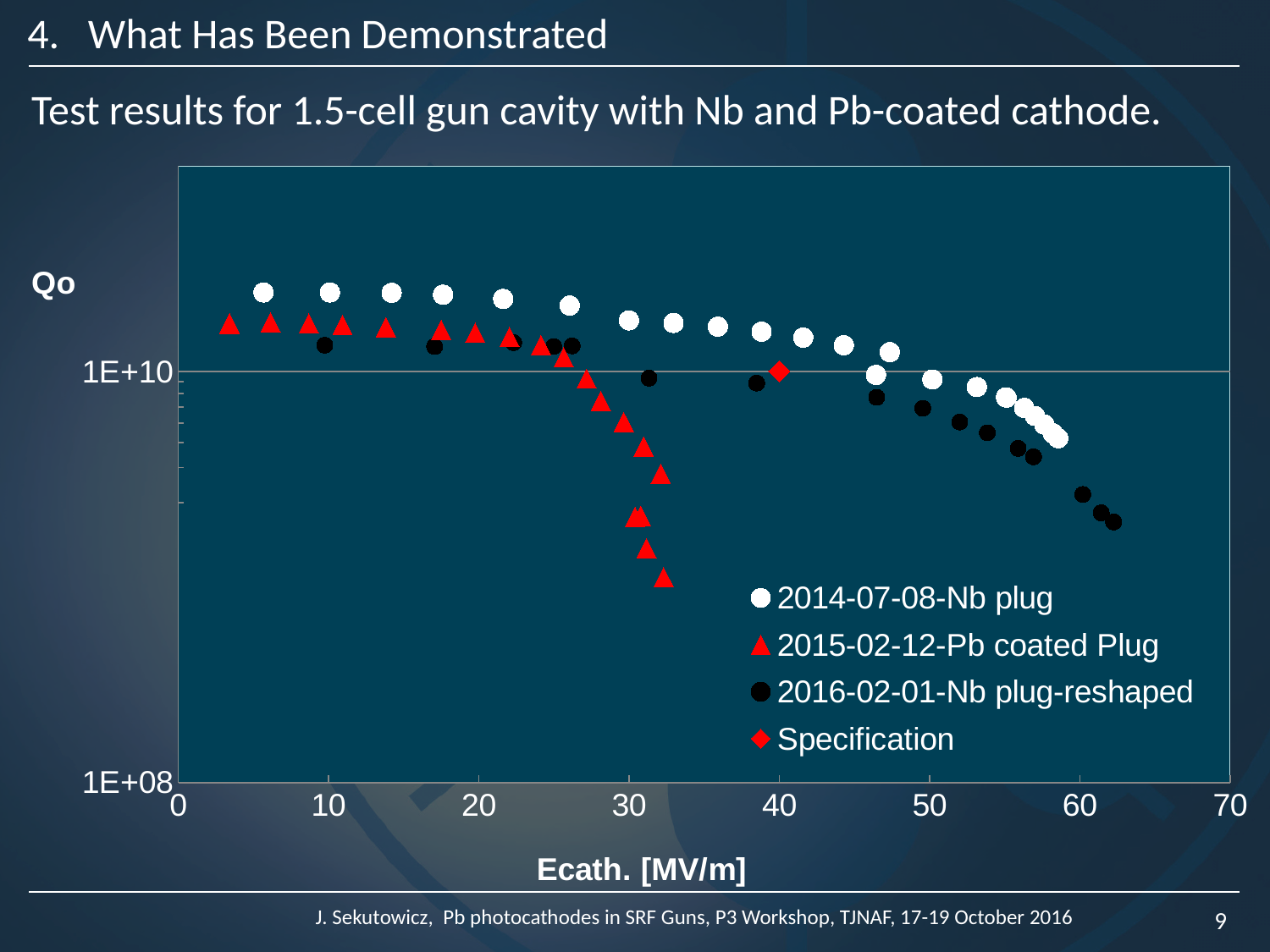
Is the Qo value for the 2015-02-12-Pb coated Plug series at its highest Ecath (around 32 MV/m) greater or less than 1E+10? less What is the label of the x axis of the chart? Ecath. [MV/m] Which series drops below 1E+10 at the lowest Ecath value? 2015-02-12-Pb coated Plug Which series reaches the highest Ecath value on the chart? 2016-02-01-Nb plug-reshaped At Ecath of about 10 MV/m, which series has the higher Qo: 2014-07-08-Nb plug or 2016-02-01-Nb plug-reshaped? 2014-07-08-Nb plug How many series does the chart legend list? 4 Does the Qo of the 2014-07-08-Nb plug series rise or fall as Ecath increases beyond 20 MV/m? fall What is the label of the y axis of the chart? Qo What Qo value does the Specification point lie on? 1E+10 Is the Qo value for the 2014-07-08-Nb plug series at Ecath of 10 MV/m greater or less than 1E+10? greater At what Ecath value is the Specification point plotted? 40 What kind of chart is shown on the slide? Scatter chart